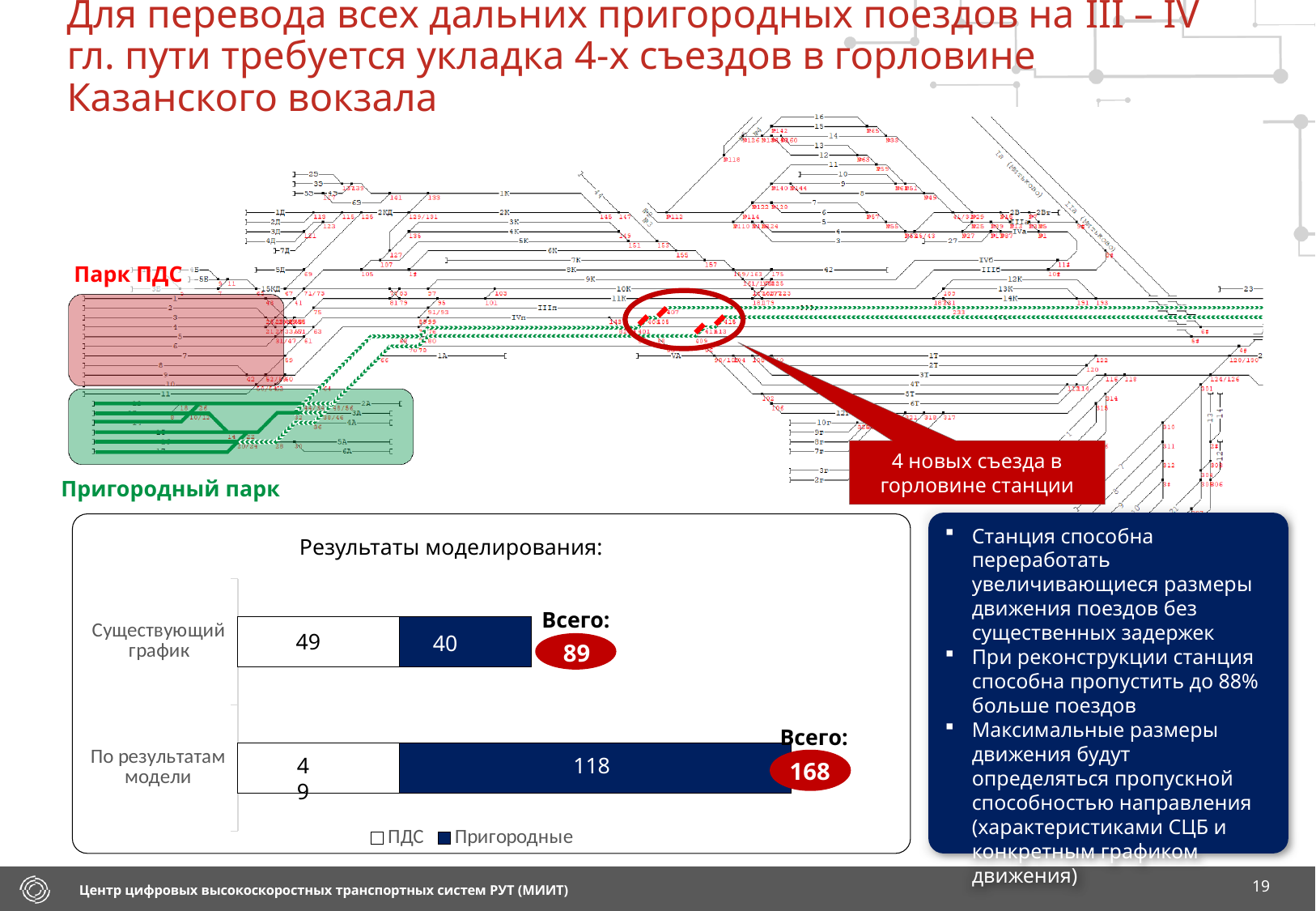
What is the difference between the Пригородные values for "По результатам модели" and "Существующий график"? 78 Which category has the higher total on the "Результаты моделирования:" chart? По результатам модели Which is larger for "Существующий график": the ПДС value or the Пригородные value? ПДС How many categories are shown on the "Результаты моделирования:" chart? 2 What is the value of Пригородные for "Существующий график"? 40 What is the value of ПДС for "Существующий график"? 49 How many series does the legend of the "Результаты моделирования:" chart list? 2 Which two series are listed in the legend of the "Результаты моделирования:" chart? ПДС and Пригородные What is the value of Пригородные for "По результатам модели"? 118 What kind of chart is shown under the title "Результаты моделирования:"? bar chart What is the total (Всего) shown for "Существующий график"? 89 What is the total (Всего) shown for "По результатам модели"? 168